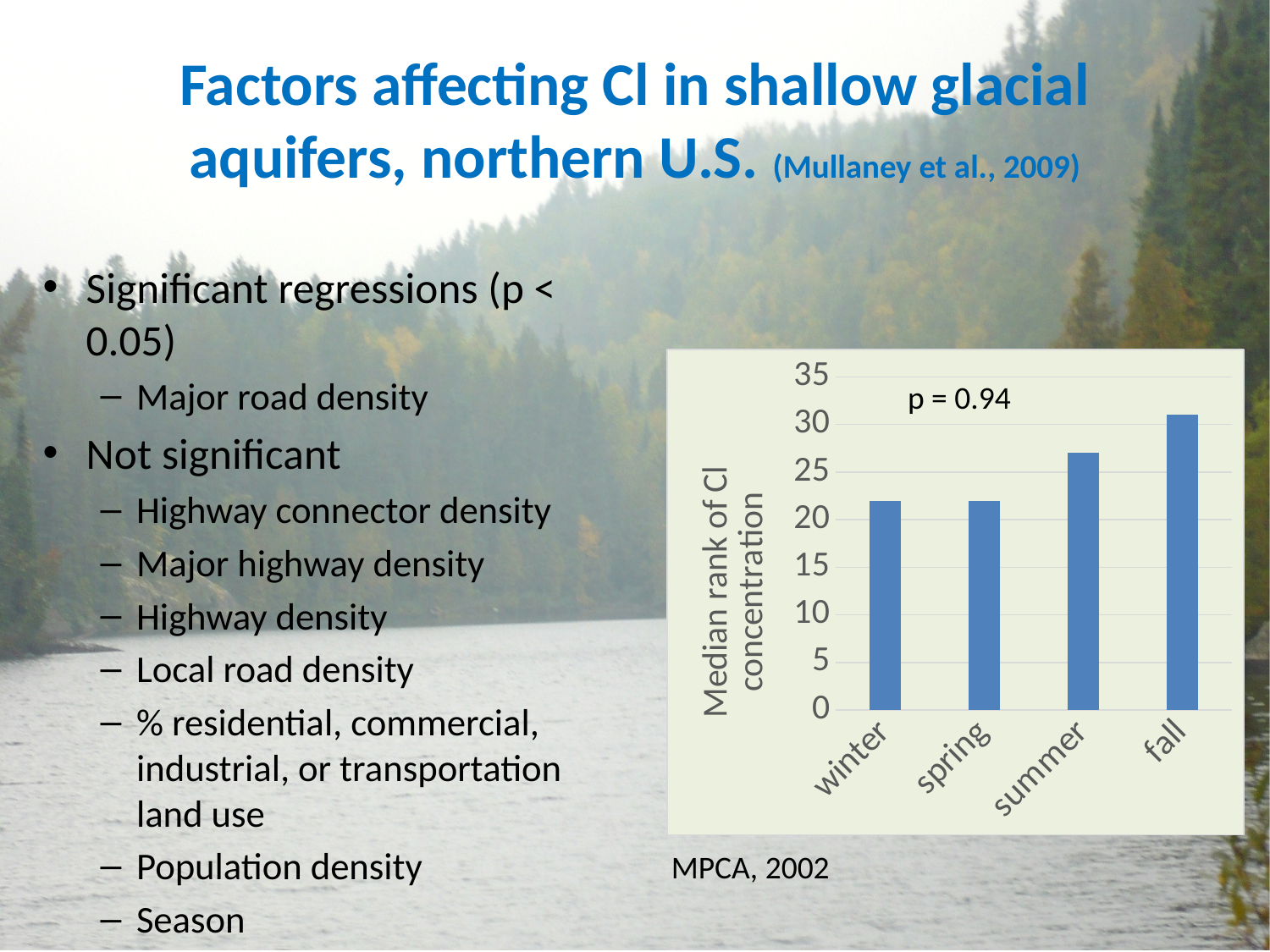
Do the bar values generally rise or fall from winter to fall along the x axis? rise Which is larger, the median rank of Cl concentration for winter or for summer? summer Which is larger, the median rank of Cl concentration for summer or for fall? fall Is the value for fall greater or less than 35? less What p-value is annotated on the chart? p = 0.94 Which season has the highest median rank of Cl concentration? fall Is the value for spring greater or less than 25? less What is the label on the vertical axis of the chart? Median rank of Cl concentration How many seasons (categories) are plotted on the chart? 4 Is the value for summer greater or less than 30? less What kind of chart is shown on the slide? bar chart